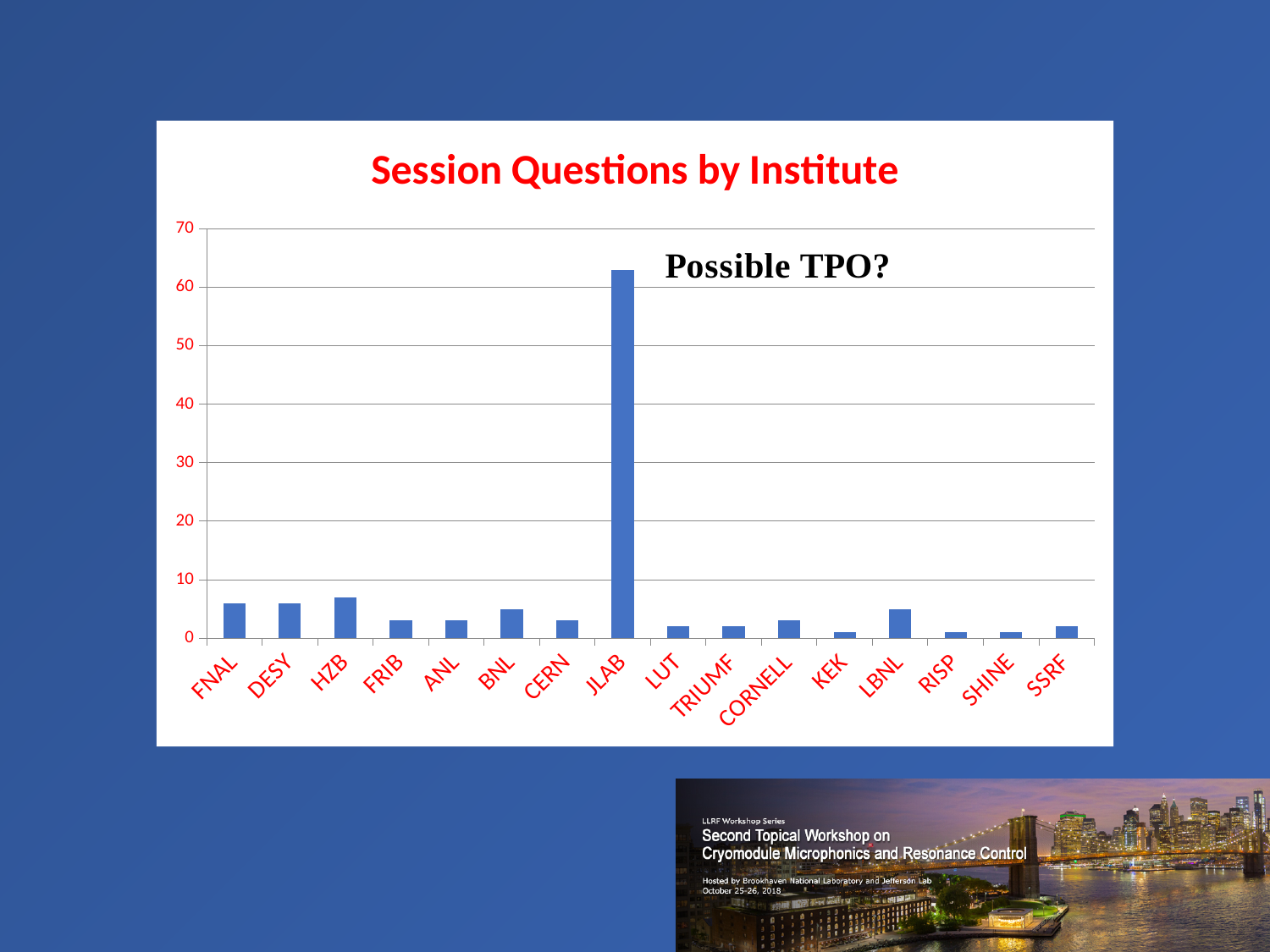
Is the value for JLAB greater or less than 60? greater What is the title of the chart? Session Questions by Institute What text annotation is placed next to the tallest bar in the chart? Possible TPO? Which has the larger value, HZB or KEK? HZB Is the value for HZB greater or less than 10? less How many institutes are shown on the x axis of the chart? 16 What kind of chart is shown on the slide? bar chart Which has the larger value, LBNL or LUT? LBNL Is the value for JLAB greater or less than 70? less Which has the larger value, JLAB or FNAL? JLAB Which institute has the highest number of session questions? JLAB